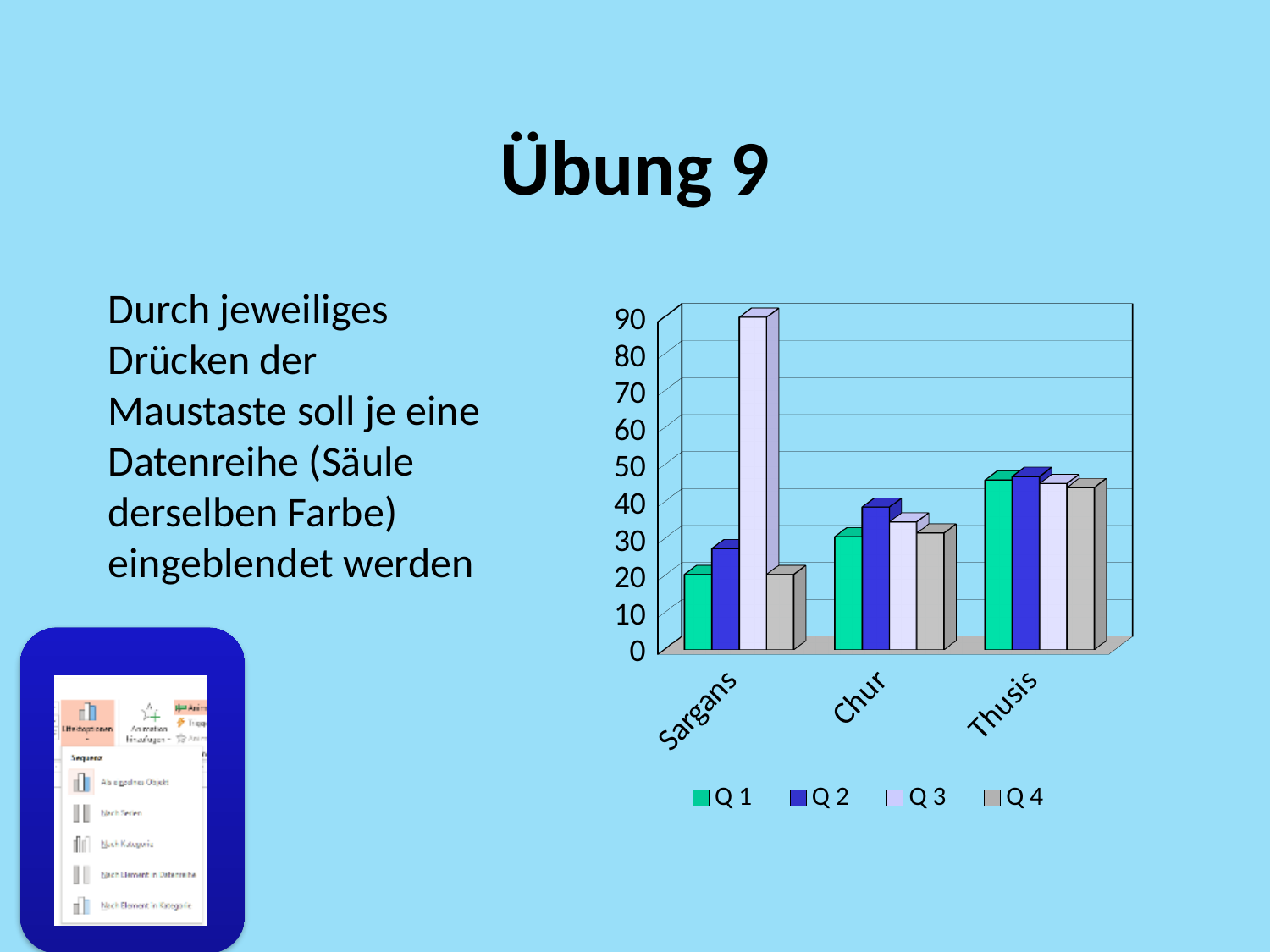
Which category has the highest Q 3 value? Sargans What are the names of the series listed in the chart's legend? Q 1, Q 2, Q 3, Q 4 Which category has the lowest Q 1 value? Sargans How many series does the chart's legend list? 4 Which is larger, the Q 3 value for Sargans or the Q 3 value for Chur? Sargans Is the Q 2 value for Chur greater or less than 30? greater How many categories are shown on the x axis of the chart? 3 Which series has the highest value for Sargans? Q 3 Is the Q 3 value for Sargans greater or less than 80? greater Is the Q 1 value for Sargans greater or less than 30? less What kind of chart is shown on the slide? bar chart